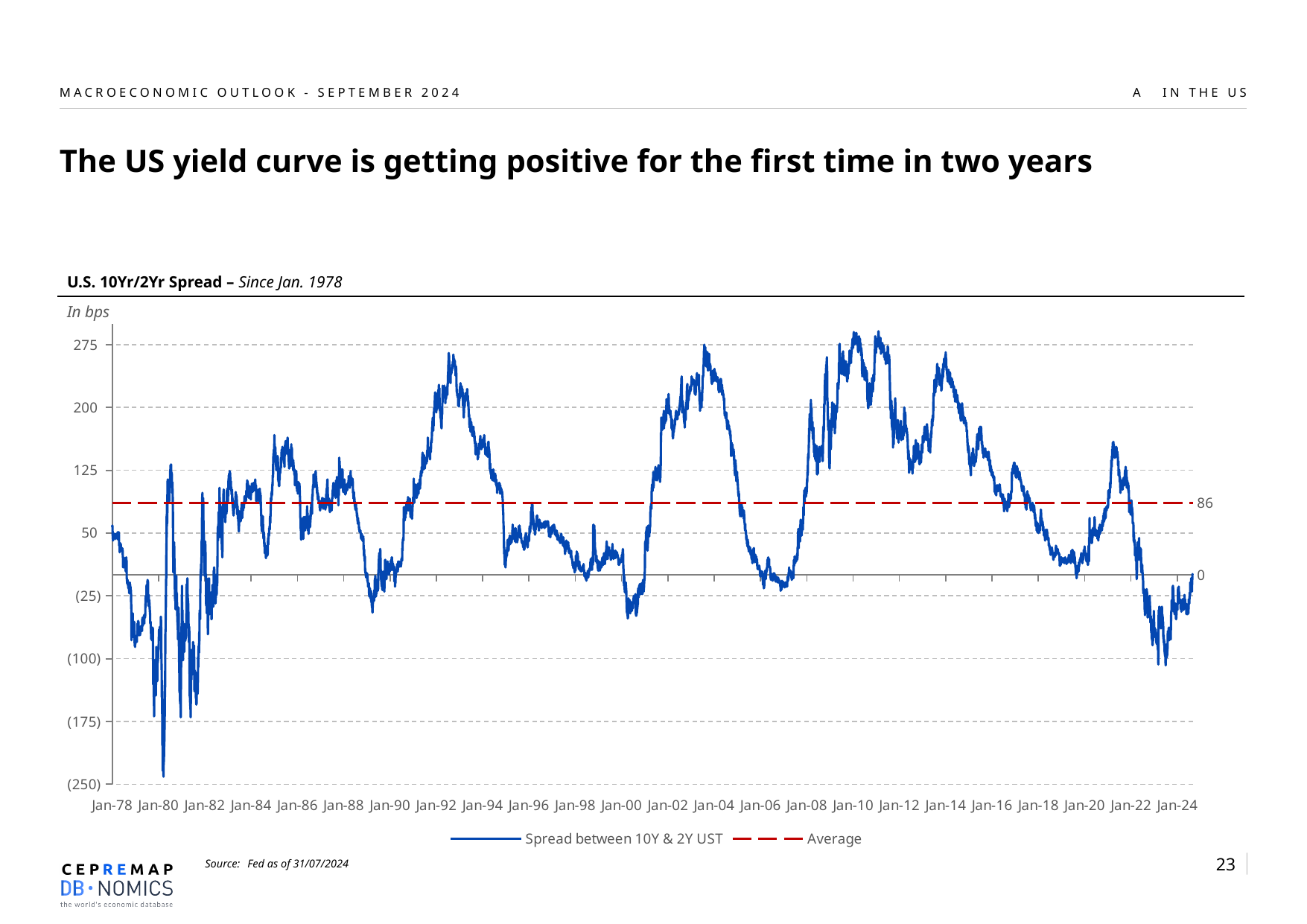
Does the spread rise or fall between Jan-90 and Jan-92? rise Is the lowest value of the spread around Jan-80 greater or less than (175)? less Around which year does the spread reach its lowest value? 1980 How many series does the legend list? 2 Is the peak of the spread around Jan-92 greater or less than 200? greater What is the value of the Average line shown on the chart? 86 Which is lower, the trough of the spread around Jan-80 or the trough around Jan-23? Jan-80 Is the value of the spread around Jan-18 greater or less than 125? less What value is labelled at the right end of the spread line? 0 In what unit are the values on the chart expressed? bps What is the title of the chart? U.S. 10Yr/2Yr Spread – Since Jan. 1978 What kind of chart is shown on the slide? line chart